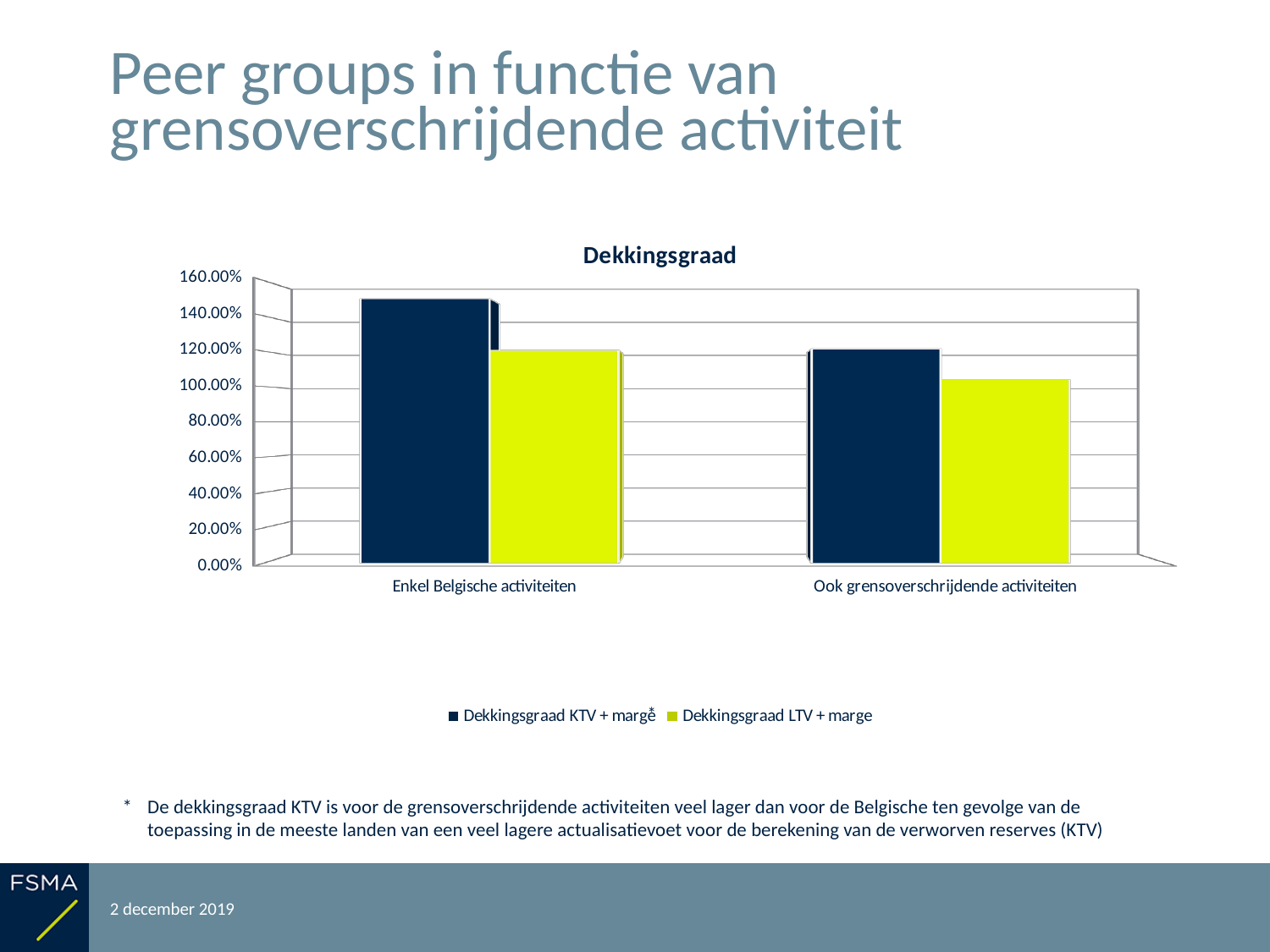
Is the value of Dekkingsgraad LTV + marge for Enkel Belgische activiteiten greater or less than 100.00%? greater Is the value of Dekkingsgraad KTV + marge for Ook grensoverschrijdende activiteiten greater or less than 140.00%? less For Enkel Belgische activiteiten, which is larger: Dekkingsgraad KTV + marge or Dekkingsgraad LTV + marge? Dekkingsgraad KTV + marge Is the value of Dekkingsgraad KTV + marge for Enkel Belgische activiteiten greater or less than 140.00%? greater Which bar in the chart is the highest? Dekkingsgraad KTV + marge for Enkel Belgische activiteiten How many categories are shown on the x axis of the chart? 2 Which series is shown in dark navy blue? Dekkingsgraad KTV + marge How many series does the chart legend list? 2 What type of chart is shown on the slide? bar chart What is the title of the chart? Dekkingsgraad For Dekkingsgraad KTV + marge, which category has the larger value: Enkel Belgische activiteiten or Ook grensoverschrijdende activiteiten? Enkel Belgische activiteiten